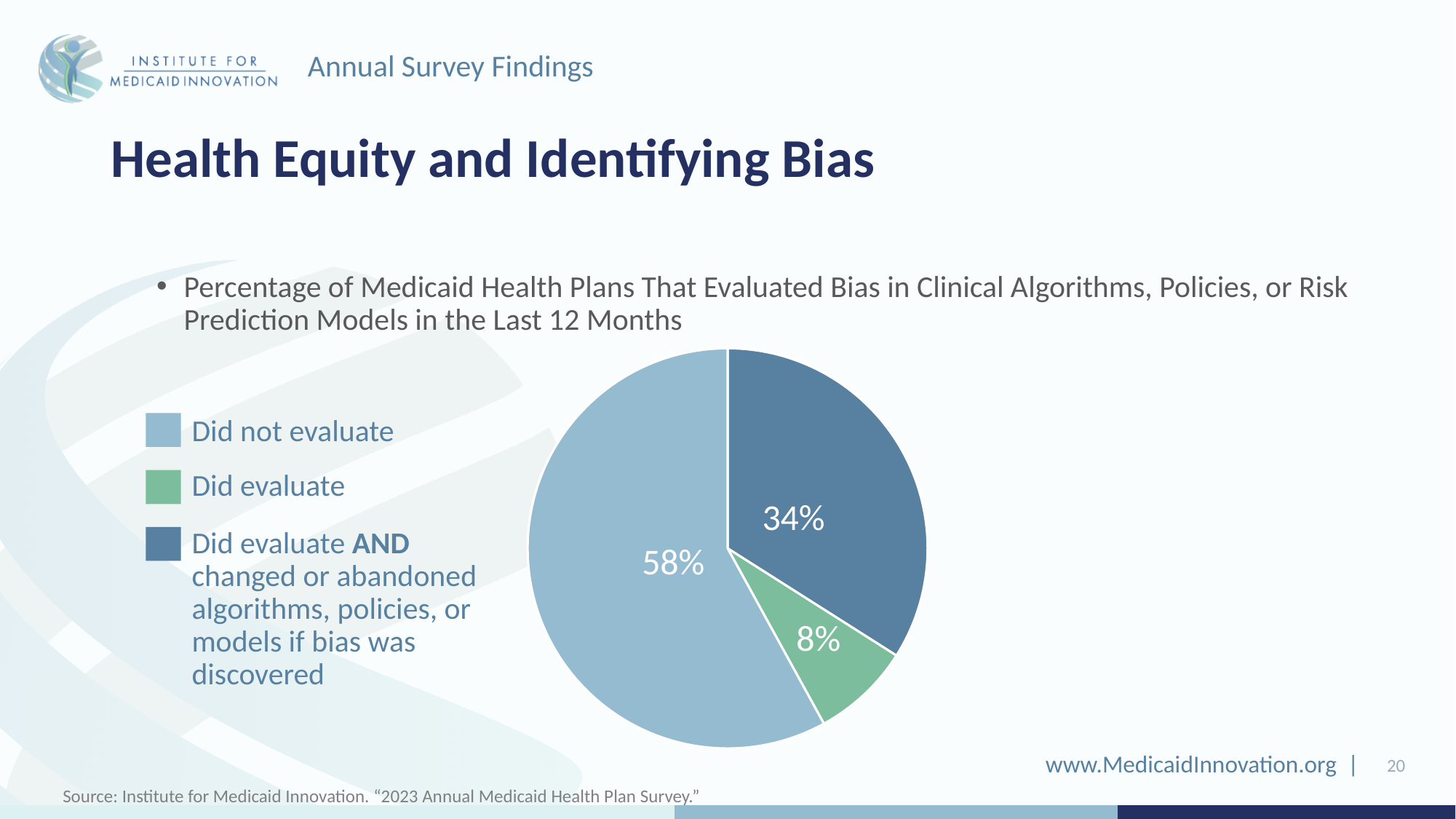
What percentage of Medicaid health plans did not evaluate bias? 58% What percentage of Medicaid health plans did evaluate bias (without changing or abandoning algorithms)? 8% What is the difference in percentage points between 'Did not evaluate' and 'Did evaluate AND changed or abandoned algorithms, policies, or models if bias was discovered'? 24 percentage points How many entries does the legend list? 3 What colour is the 'Did evaluate' slice in the pie chart? green What kind of chart is shown on the slide? pie chart Which category has the largest share of the pie? Did not evaluate What is the combined share of plans that evaluated bias (with or without changing algorithms)? 42% How many slices does the pie chart have? 3 Which is larger: the share for 'Did evaluate' or the share for 'Did evaluate AND changed or abandoned algorithms, policies, or models if bias was discovered'? Did evaluate AND changed or abandoned algorithms, policies, or models if bias was discovered Which category has the smallest share of the pie? Did evaluate What percentage of Medicaid health plans did evaluate AND changed or abandoned algorithms, policies, or models if bias was discovered? 34%